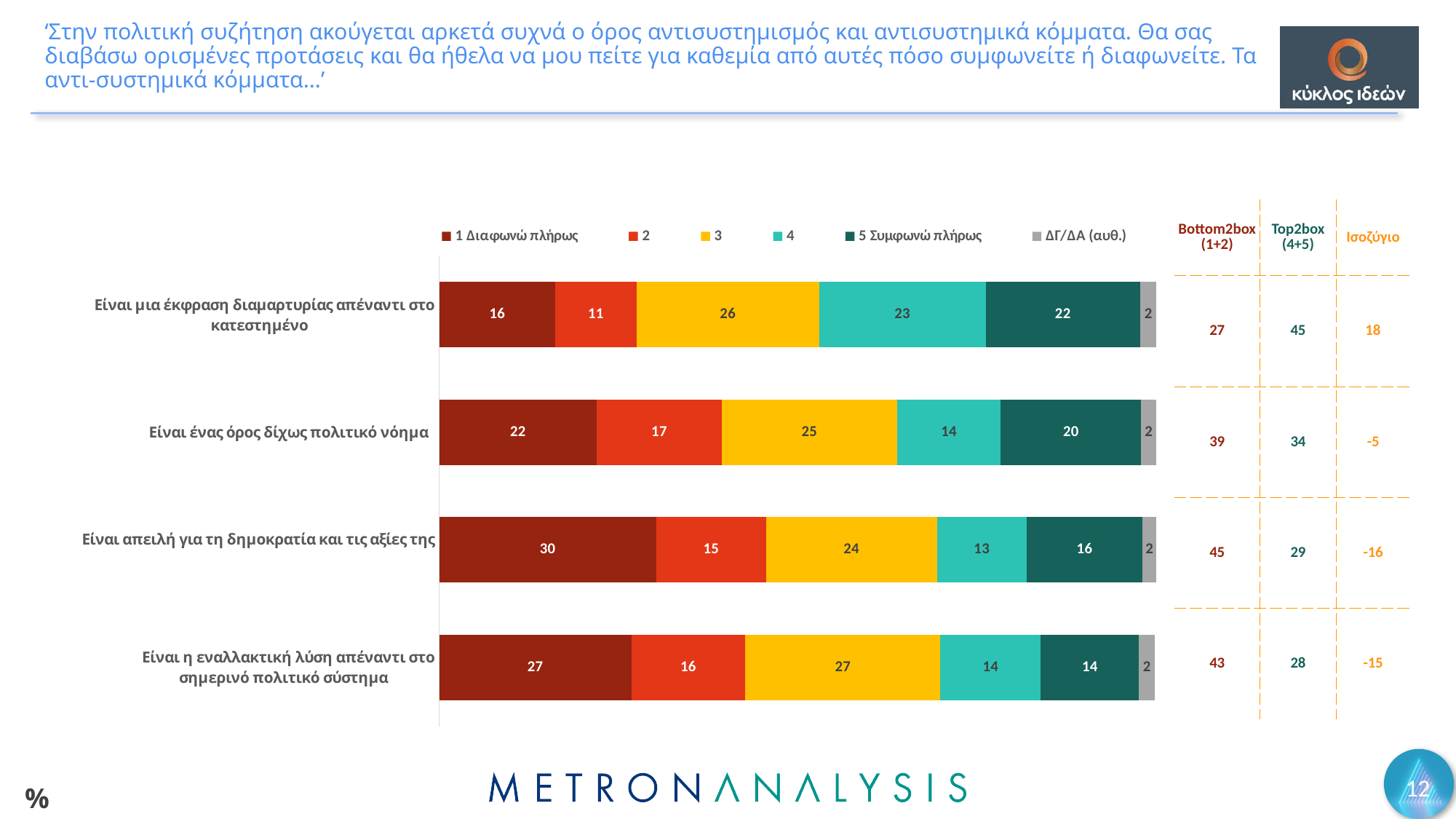
How many series does the legend list? 6 What is the total of the stacked bar for 'Είναι ένας όρος δίχως πολιτικό νόημα'? 100 What is the value of '5 Συμφωνώ πλήρως' for 'Είναι μια έκφραση διαμαρτυρίας απέναντι στο κατεστημένο'? 22 What is the difference between the '1 Διαφωνώ πλήρως' values for 'Είναι απειλή για τη δημοκρατία και τις αξίες της' and 'Είναι μια έκφραση διαμαρτυρίας απέναντι στο κατεστημένο'? 14 What is the value of '1 Διαφωνώ πλήρως' for 'Είναι απειλή για τη δημοκρατία και τις αξίες της'? 30 What is the Ισοζύγιο value shown for 'Είναι απειλή για τη δημοκρατία και τις αξίες της'? -16 Which statement has the highest value for '1 Διαφωνώ πλήρως'? Είναι απειλή για τη δημοκρατία και τις αξίες της Which is larger: the value of series '4' for 'Είναι μια έκφραση διαμαρτυρίας απέναντι στο κατεστημένο' or for 'Είναι ένας όρος δίχως πολιτικό νόημα'? Είναι μια έκφραση διαμαρτυρίας απέναντι στο κατεστημένο What is the value of series '3' for 'Είναι η εναλλακτική λύση απέναντι στο σημερινό πολιτικό σύστημα'? 27 How many statements (categories) are plotted in the chart? 4 Which statement has the lowest value for '5 Συμφωνώ πλήρως'? Είναι η εναλλακτική λύση απέναντι στο σημερινό πολιτικό σύστημα What kind of chart is shown on the slide? Stacked bar chart